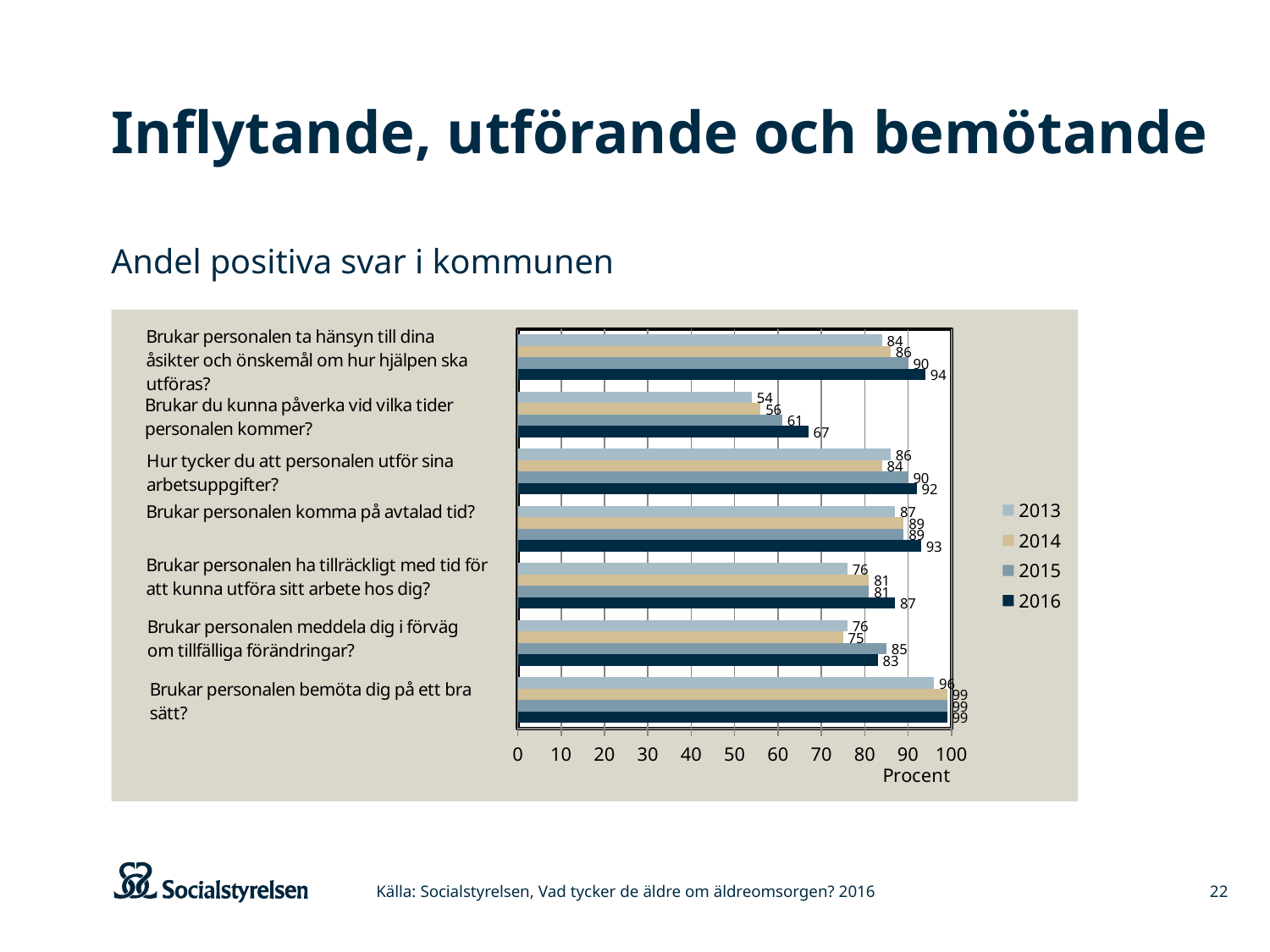
How many survey questions (categories) are plotted in the chart? 7 Which survey question has the highest 2013 value? Brukar personalen bemöta dig på ett bra sätt? What is the difference between the 2016 and 2013 values for "Brukar du kunna påverka vid vilka tider personalen kommer?"? 13 Do the values for "Brukar personalen ha tillräckligt med tid för att kunna utföra sitt arbete hos dig?" rise or fall from 2013 to 2016? rise Which survey question has the lowest 2016 value? Brukar du kunna påverka vid vilka tider personalen kommer? What is the 2015 value for "Brukar personalen meddela dig i förväg om tillfälliga förändringar?"? 85 What is the 2016 value for "Brukar personalen ta hänsyn till dina åsikter och önskemål om hur hjälpen ska utföras?"? 94 For "Brukar personalen meddela dig i förväg om tillfälliga förändringar?", which is larger, the 2015 value or the 2016 value? 2015 What kind of chart is shown on the slide? bar chart What is the 2013 value for "Brukar du kunna påverka vid vilka tider personalen kommer?"? 54 What is the label on the horizontal axis of the chart? Procent How many series does the legend list? 4